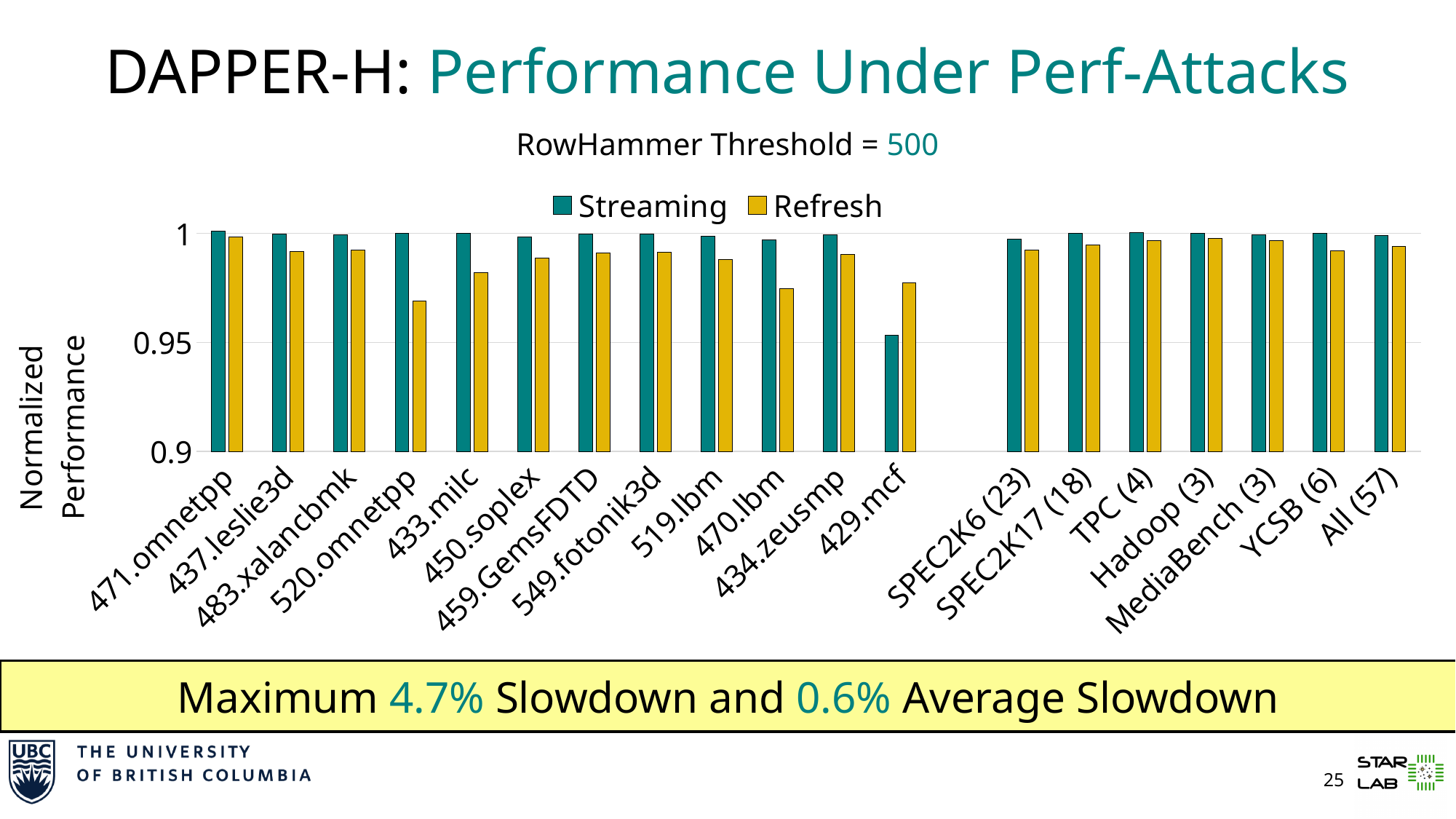
What kind of chart is shown on the slide? bar chart What is the label of the y axis? Normalized Performance How many categories are shown along the x axis? 19 Is the Streaming value for 429.mcf greater or less than 0.9? greater Is the Refresh value for 520.omnetpp greater or less than 0.95? greater Which category has the lowest Refresh value? 520.omnetpp Is the Refresh value for 470.lbm greater or less than 0.95? greater Which category has the lowest Streaming value? 429.mcf How many series does the legend list? 2 For 429.mcf, which is larger: the Streaming value or the Refresh value? Refresh What RowHammer Threshold is stated above the chart? 500 For 520.omnetpp, which is larger: the Streaming value or the Refresh value? Streaming